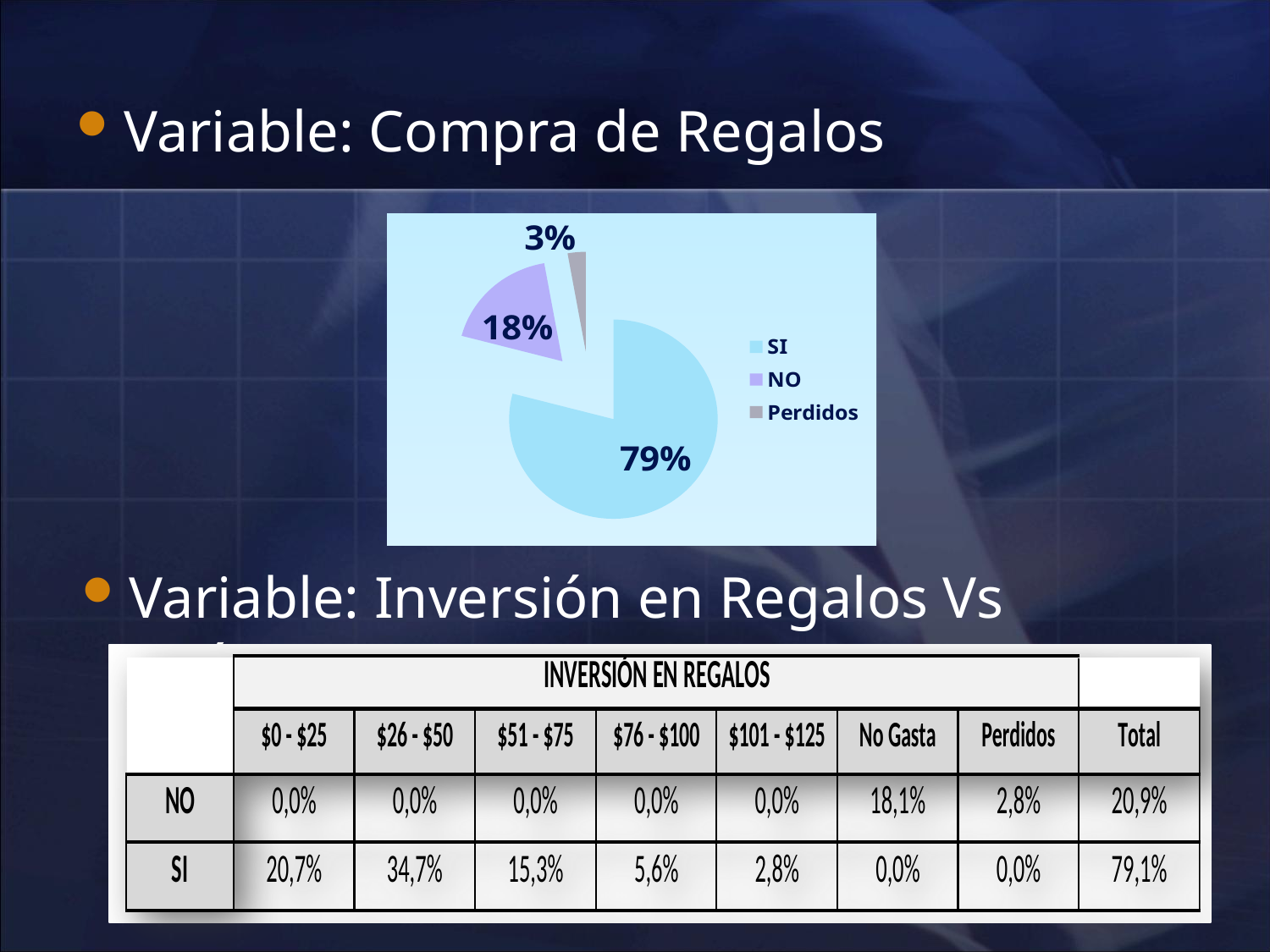
How many categories does the pie chart show? 3 What colour is the SI slice in the pie chart? light blue What kind of chart is shown on the slide? pie chart What percentage of the pie chart corresponds to NO? 18% Which category has the smallest slice in the pie chart? Perdidos Which category has the largest slice in the pie chart? SI How many entries does the pie chart legend list? 3 What is the difference in percentage points between the NO slice and the Perdidos slice? 15 What percentage of the pie chart corresponds to SI? 79% Which slice is larger in the pie chart, NO or Perdidos? NO What percentage of the pie chart corresponds to Perdidos? 3% What is the difference in percentage points between the SI slice and the NO slice? 61